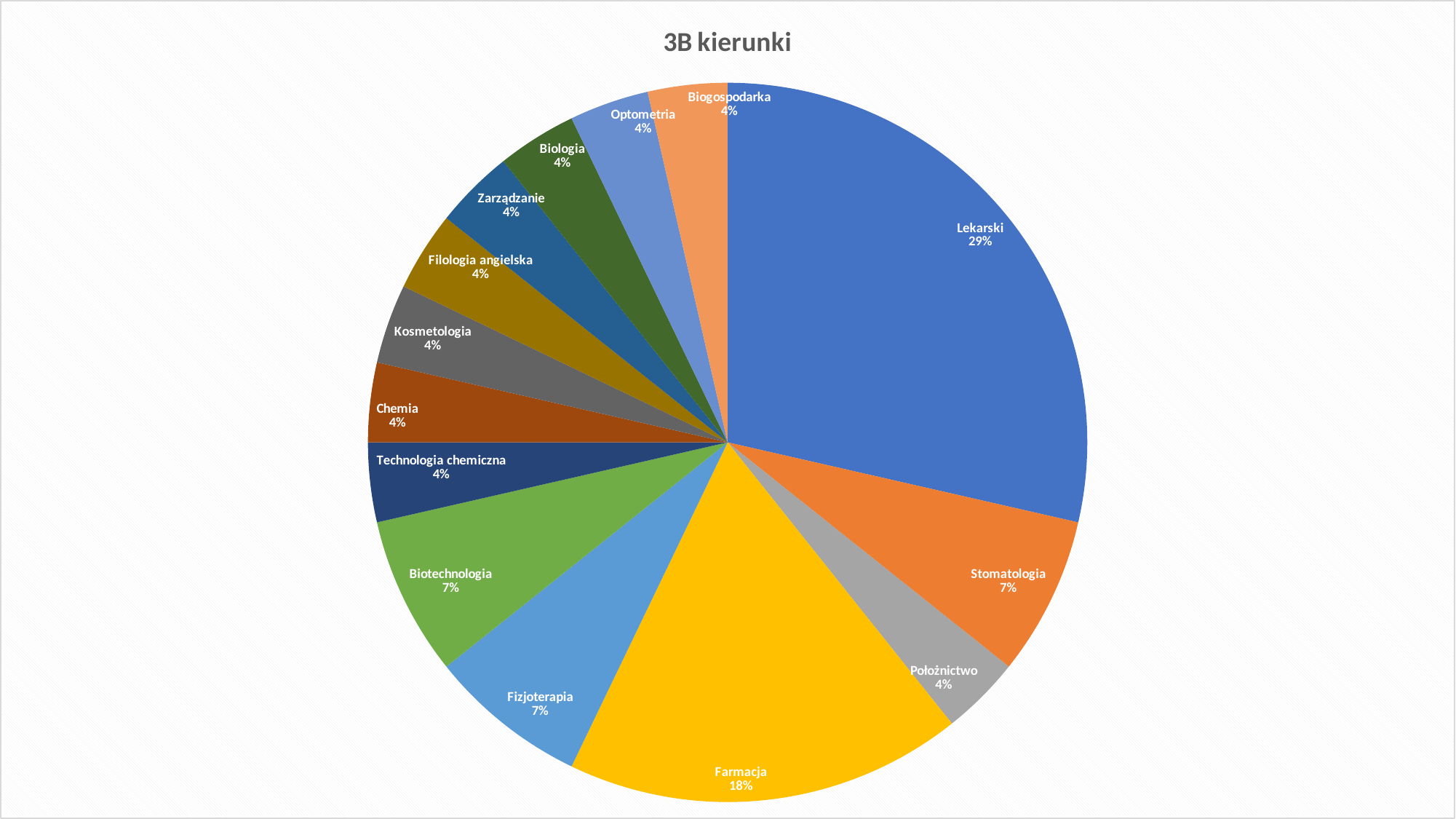
How many slices does the pie chart have? 14 Which category has the largest slice of the pie? Lekarski What percentage is shown for Kosmetologia? 4% What share of the pie does Lekarski have? 29% What share of the pie does Farmacja have? 18% What percentage is shown for Technologia chemiczna? 4% What is the difference between the shares of Lekarski and Farmacja? 11% What kind of chart is shown on the slide? pie chart Which is larger, the share for Fizjoterapia or the share for Położnictwo? Fizjoterapia What is the difference between the shares of Farmacja and Biotechnologia? 11% What is the title of the chart? 3B kierunki What percentage is shown for Stomatologia? 7%